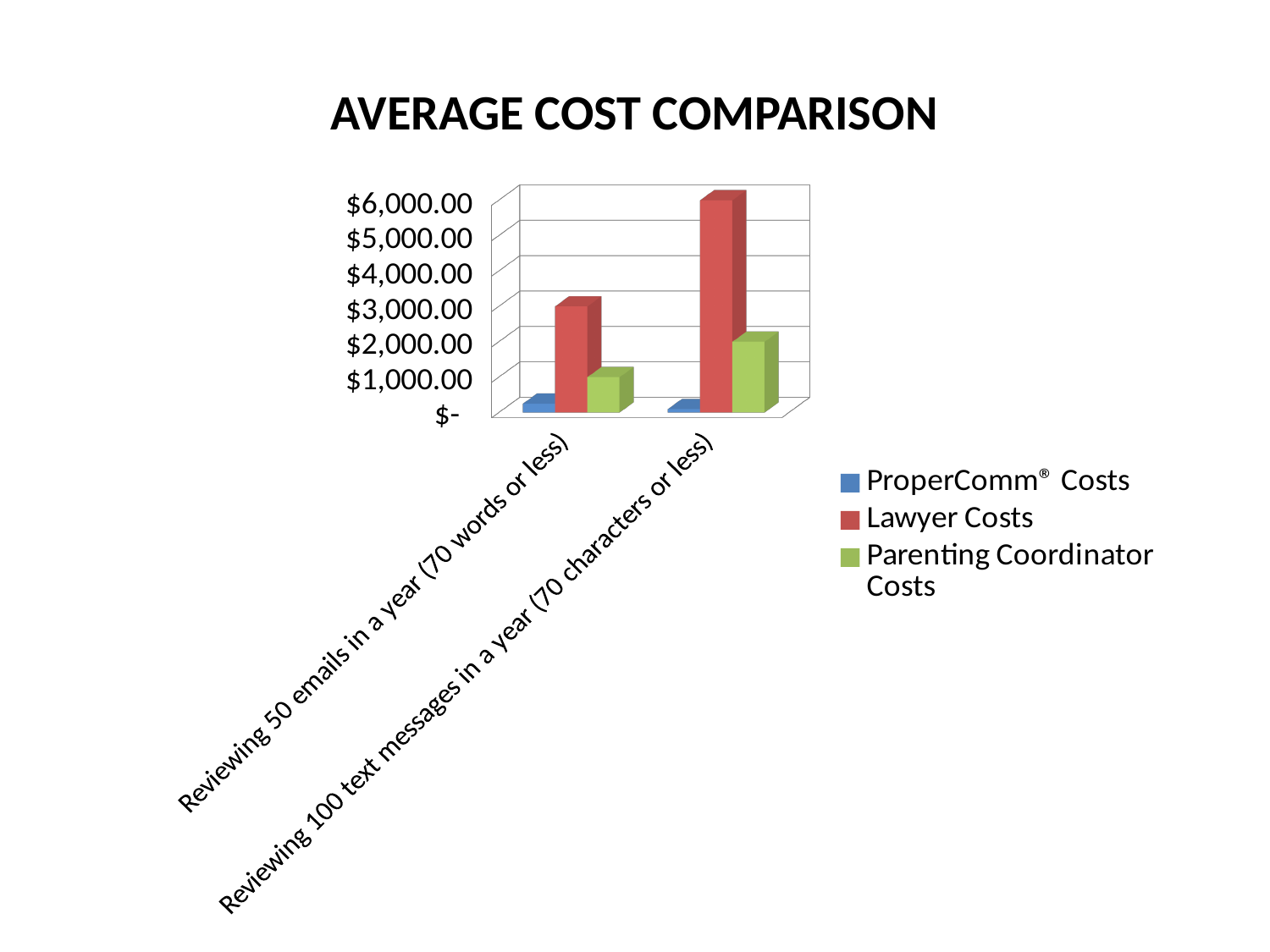
What kind of chart is shown on the slide? Bar chart Which series has the highest bar in the chart? Lawyer Costs Is the Lawyer Costs value for Reviewing 100 text messages in a year greater or less than $5,000.00? greater Is the Lawyer Costs value for Reviewing 50 emails in a year greater or less than $2,000.00? greater Is the ProperComm Costs value for Reviewing 100 text messages in a year greater or less than $1,000.00? less What is the title of the chart? AVERAGE COST COMPARISON For Reviewing 50 emails in a year, which is larger: Lawyer Costs or Parenting Coordinator Costs? Lawyer Costs Do Lawyer Costs rise or fall from Reviewing 50 emails in a year to Reviewing 100 text messages in a year? rise Which series has the lowest bars in both categories? ProperComm Costs How many categories are shown on the x axis? 2 How many series does the legend list? 3